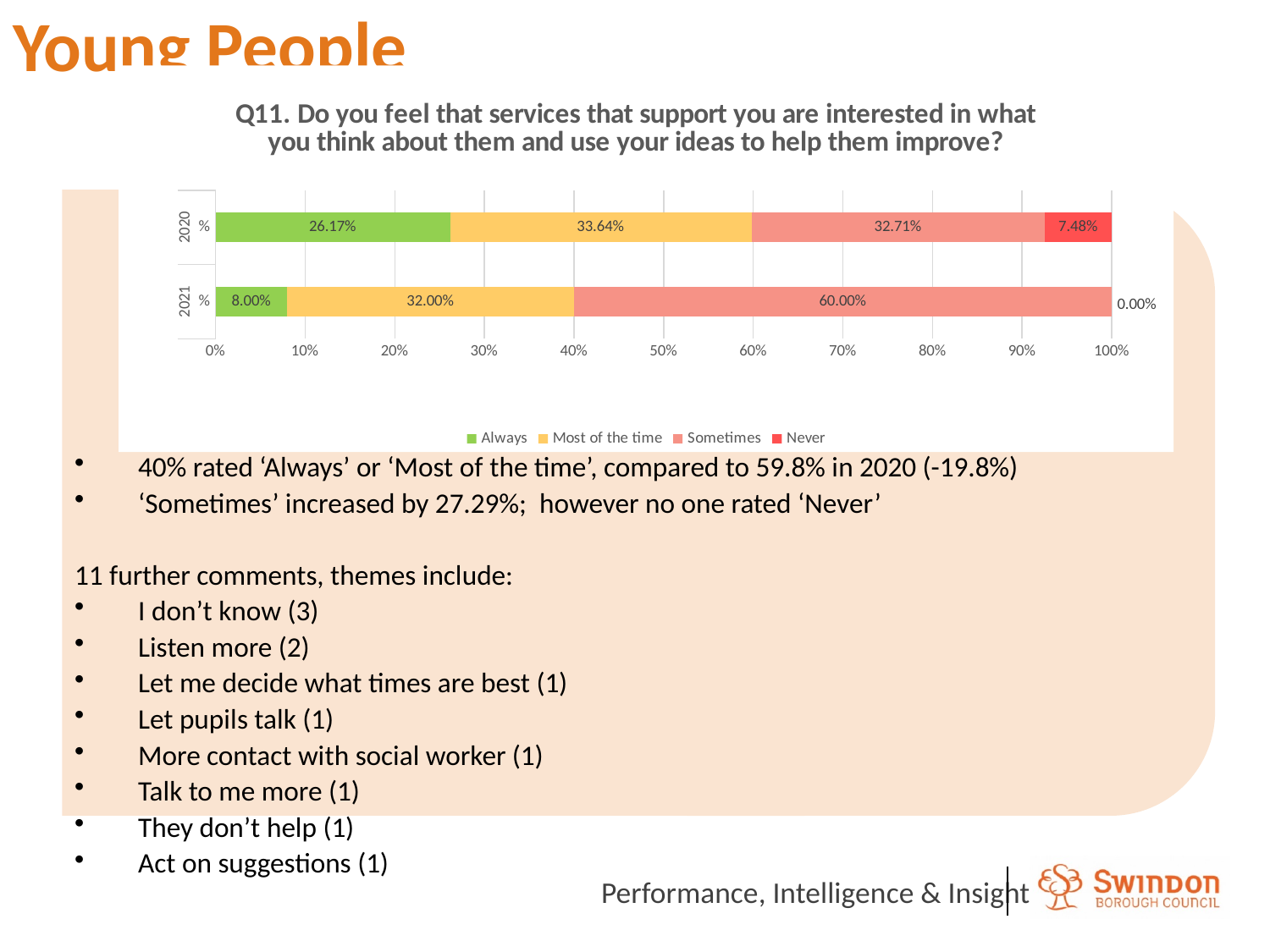
Which year has the larger 'Sometimes' value, 2020 or 2021? 2021 Which response category has the largest share in 2021? Sometimes What kind of chart is shown on the slide? Stacked bar chart How many years (categories) are plotted on the chart? 2 What is the 'Always' value for 2020? 26.17% What is the 'Never' value for 2021? 0.00% What is the 'Sometimes' value for 2021? 60.00% Which response category has the smallest share in 2020? Never What is the 'Most of the time' value for 2020? 33.64% What colour represents the 'Always' series in the chart? Green How many series does the chart legend list? 4 What is the difference between the 'Always' values for 2020 and 2021? 18.17%